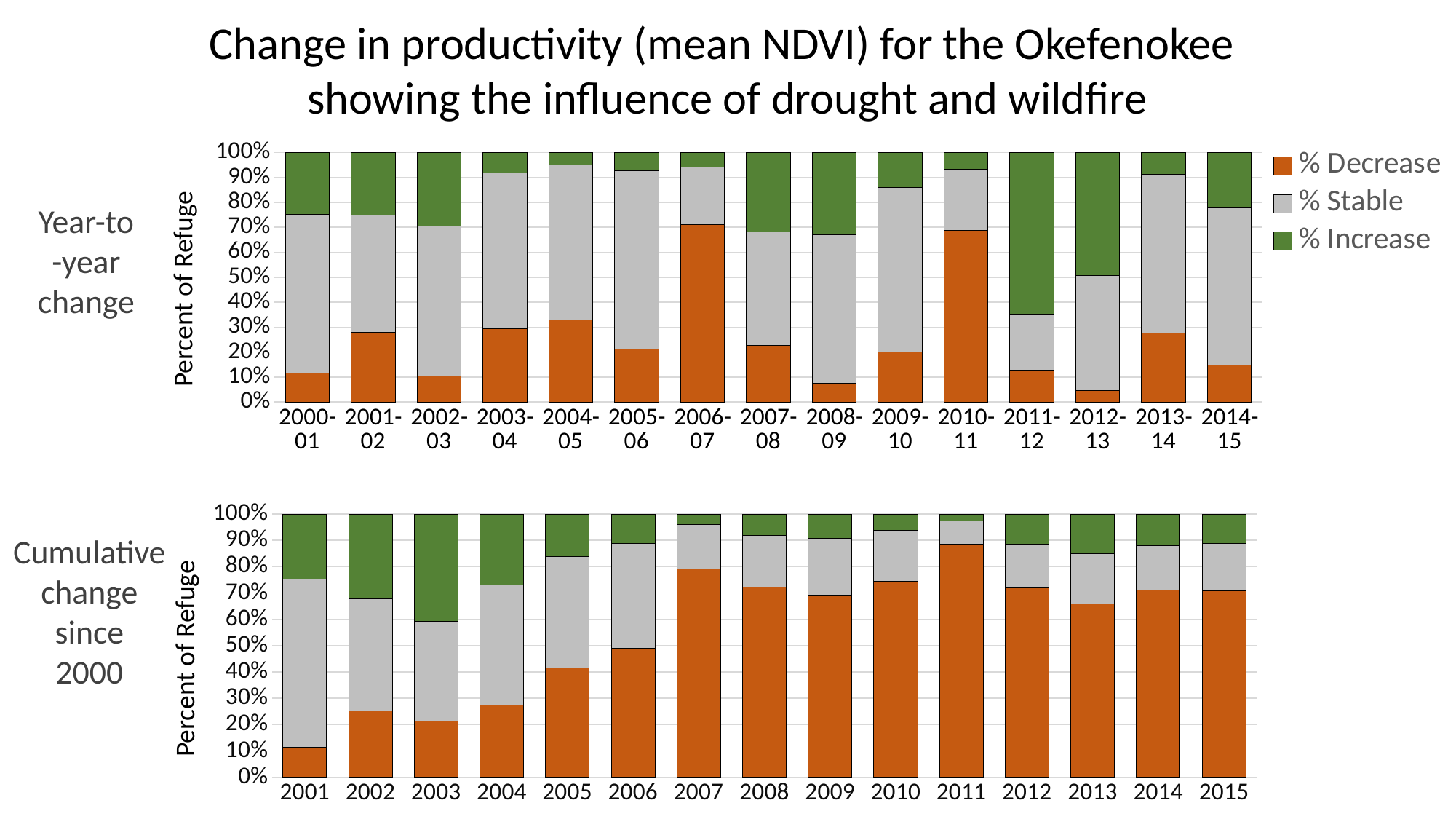
In the bottom chart (Cumulative change since 2000), does the % Decrease generally rise or fall from 2001 to 2007? rise In the top chart (Year-to-year change), which period has the highest % Increase? 2011-12 In the bottom chart (Cumulative change since 2000), which year has the lowest % Decrease? 2001 In the bottom chart (Cumulative change since 2000), which year has the larger % Decrease, 2005 or 2007? 2007 In the bottom chart (Cumulative change since 2000), is the % Decrease for 2001 greater or less than 20%? less In the bottom chart (Cumulative change since 2000), how many years are shown on the x axis? 15 In the top chart (Year-to-year change), is the % Decrease for 2006-07 greater or less than 60%? greater In the bottom chart (Cumulative change since 2000), which year has the highest % Increase? 2003 What type of chart is the top chart (Year-to-year change)? Stacked bar chart In the top chart (Year-to-year change), is the % Increase for 2011-12 greater or less than 50%? greater How many series does the legend list? 3 In the bottom chart (Cumulative change since 2000), which year has the highest % Decrease? 2011